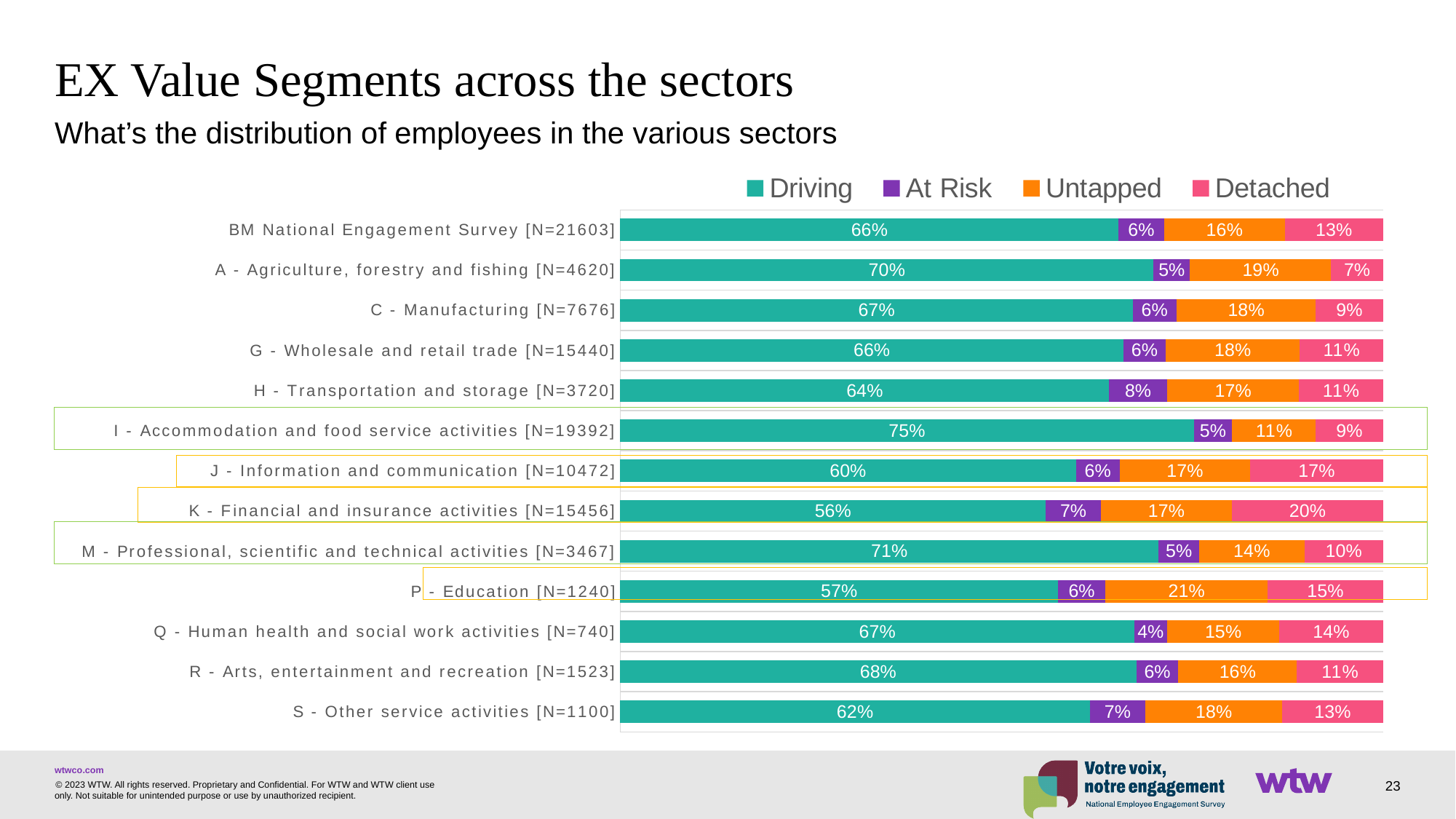
What is the difference in Driving value between I - Accommodation and food service activities and K - Financial and insurance activities? 19 percentage points What is the Untapped value for P - Education? 21% How many sectors (bars) are plotted in the chart? 13 Which sector has the highest Driving value? I - Accommodation and food service activities Which sector has the highest At Risk value? H - Transportation and storage What is the At Risk value for the BM National Engagement Survey bar? 6% What type of chart is shown on the slide? Stacked bar chart Which has a larger Detached value: J - Information and communication or A - Agriculture, forestry and fishing? J - Information and communication What is the Detached value for K - Financial and insurance activities? 20% How many series does the legend list? 4 What is the Driving value for I - Accommodation and food service activities? 75% Which sector has the lowest Driving value? K - Financial and insurance activities